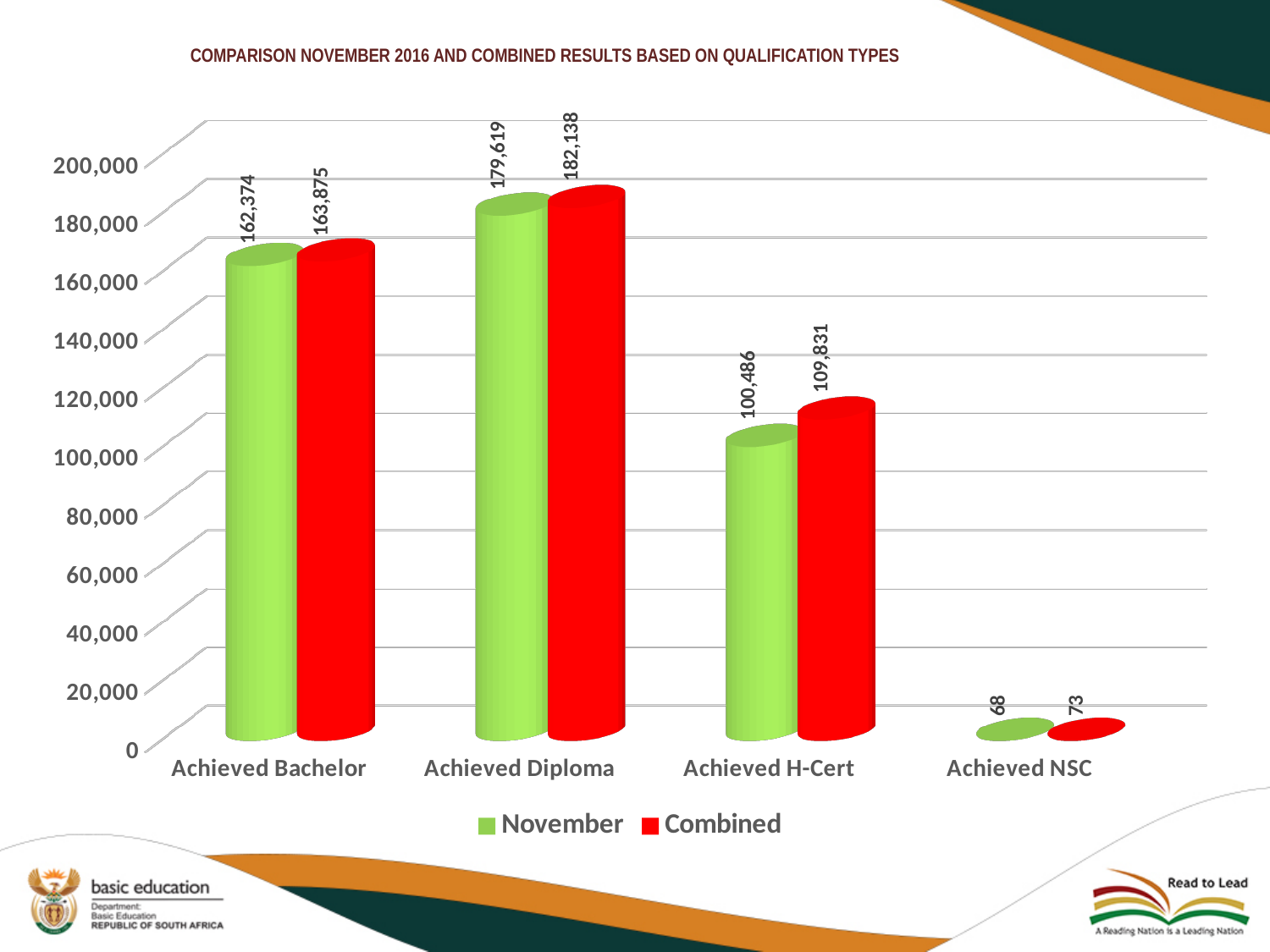
What is the November value for Achieved Bachelor? 162,374 How many qualification types are shown on the x axis? 4 What is the Combined value for Achieved H-Cert? 109,831 What kind of chart is shown on the slide? bar chart What is the Combined value for Achieved Diploma? 182,138 Is the November value for Achieved Diploma greater or less than 160,000? greater What is the November value for Achieved NSC? 68 Which qualification type has the lowest November value? Achieved NSC Which qualification type has the highest Combined value? Achieved Diploma What is the difference between the Combined and November values for Achieved H-Cert? 9,345 How many series does the legend list? 2 Which is larger for Achieved Bachelor, the November value or the Combined value? Combined